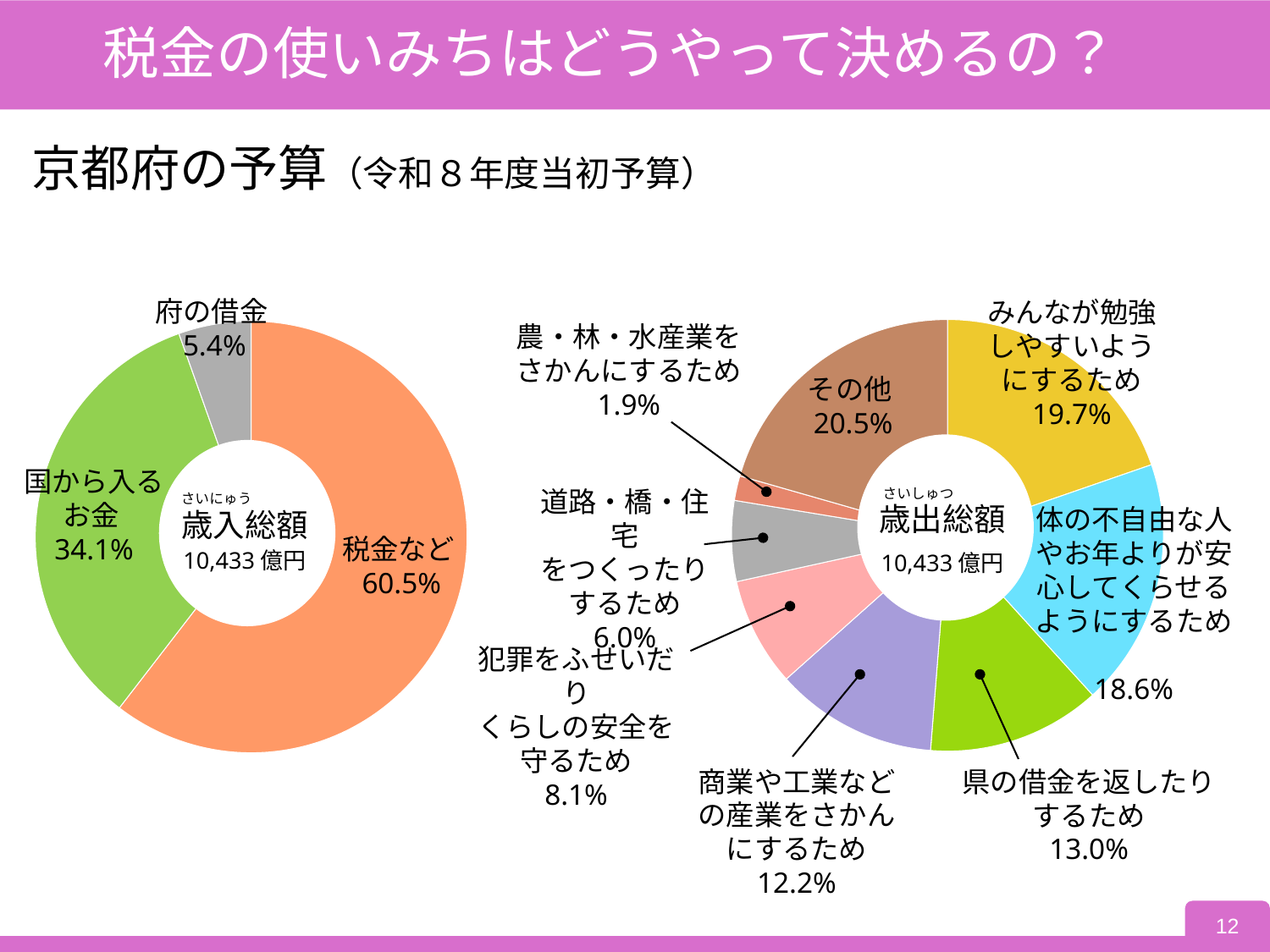
In the left chart (歳入総額), what is the difference between 税金など and 国から入るお金? 26.4% What type of chart is the right chart (歳出総額)? Pie (donut) chart In the left chart (歳入総額), which category has the largest share? 税金など In the left chart (歳入総額), how many categories are shown? 3 In the right chart (歳出総額), what share is 農・林・水産業をさかんにするため? 1.9% In the left chart (歳入総額), what share is 府の借金? 5.4% In the right chart (歳出総額), which is larger: 商業や工業などの産業をさかんにするため or 犯罪をふせいだりくらしの安全を守るため? 商業や工業などの産業をさかんにするため In the left chart (歳入総額), what share is 税金など? 60.5% In the right chart (歳出総額), which category has the smallest share? 農・林・水産業をさかんにするため In the right chart (歳出総額), what share is 県の借金を返したりするため? 13.0% What total amount is shown in the centre of the left chart (歳入総額)? 10,433 億円 In the right chart (歳出総額), how many categories are shown? 8